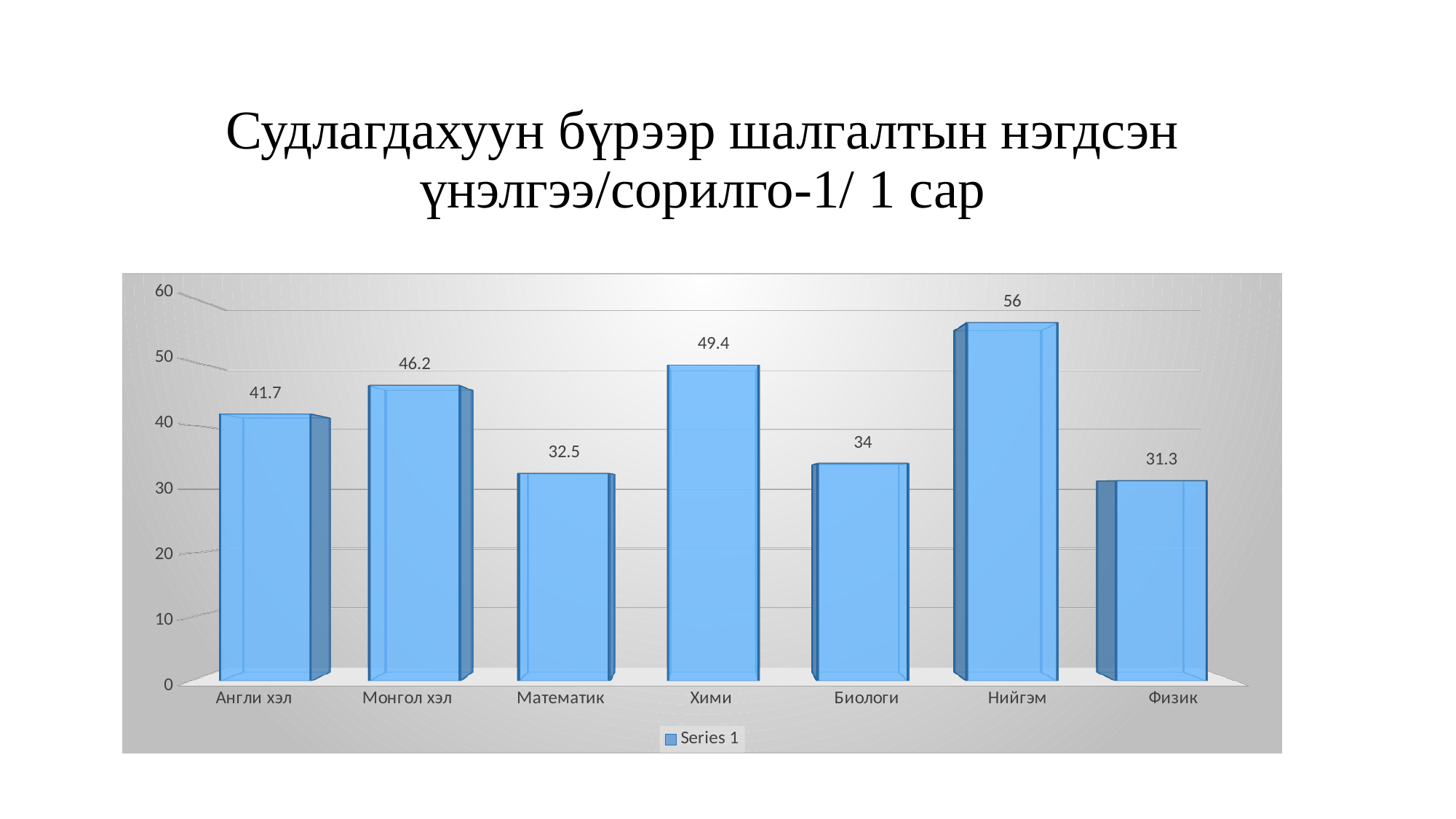
What is the difference between the values for Монгол хэл and Биологи? 12.2 Which category has the lowest value? Физик How many categories are shown on the x axis? 7 Is the value for Биологи greater or less than 40? less How many series does the legend list? 1 What is the value for Хими? 49.4 What is the value for Физик? 31.3 Which is larger, the value for Монгол хэл or the value for Хими? Хими Which category has the highest value? Нийгэм What kind of chart is shown on the slide? bar chart What is the value for Англи хэл? 41.7 What is the difference between the values for Нийгэм and Математик? 23.5